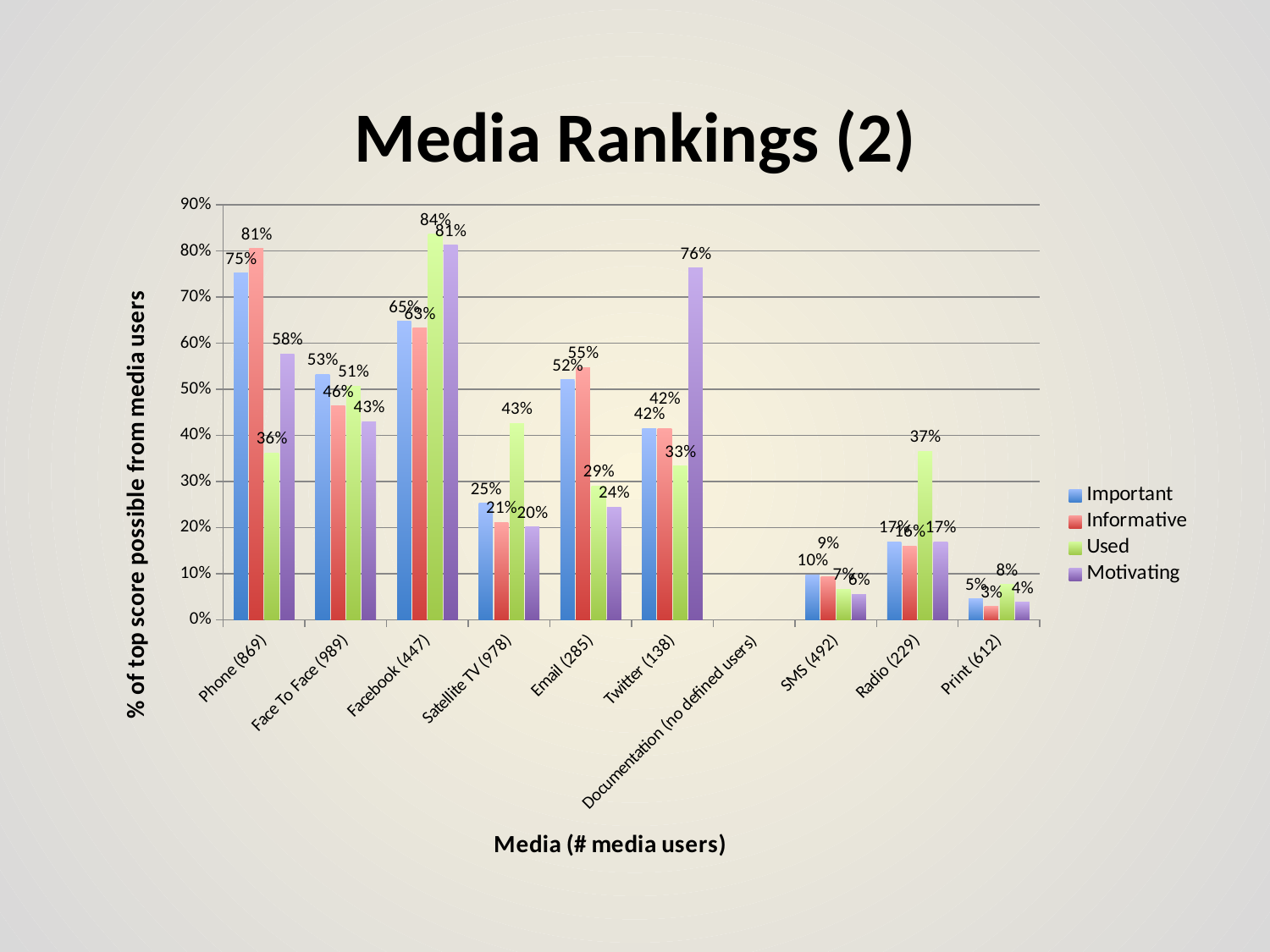
What kind of chart is shown on the slide? Bar chart Which is larger for Email (285): the Important value or the Informative value? Informative What is the Informative value for Phone (869)? 81% Is the Motivating value for Phone (869) greater or less than 50%? greater How many media categories are shown on the x axis? 10 What is the Used value for Facebook (447)? 84% Which media category has the highest Used value? Facebook (447) How many series does the legend list? 4 What is the title of the chart's y axis? % of top score possible from media users Which media category has the lowest Informative value? Print (612) What is the Motivating value for Twitter (138)? 76% What is the difference between the Used value and the Important value for Radio (229)? 20%